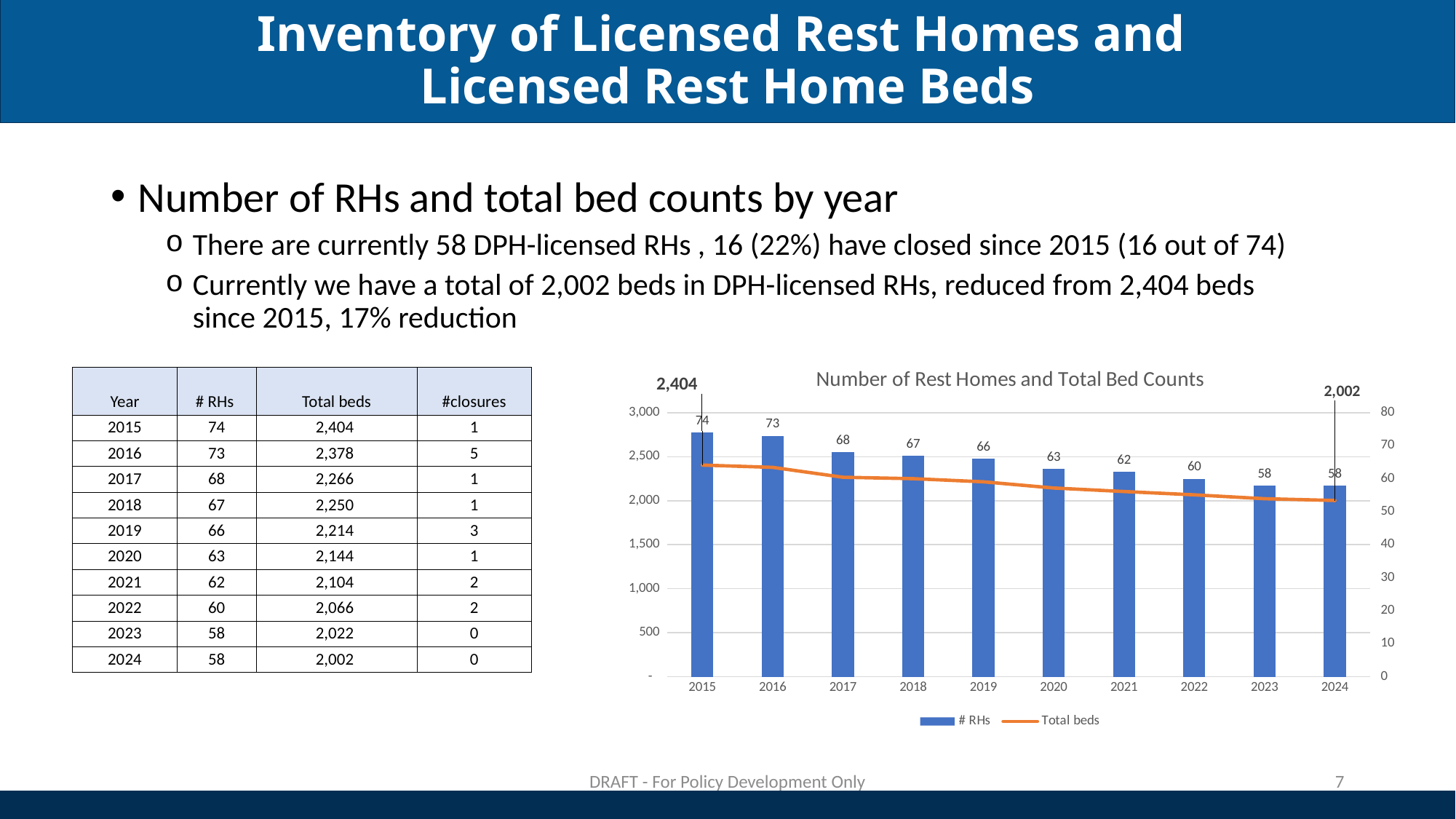
Is the Total beds value for 2019 greater or less than 2,000? greater What is the value of # RHs for 2020 in the chart? 63 How many years are shown on the x axis of the chart? 10 How many series does the chart legend list? 2 What is the difference in Total beds between 2015 and 2024 as labelled in the chart? 402 What is the title of the chart? Number of Rest Homes and Total Bed Counts Which is larger in the chart, # RHs for 2017 or # RHs for 2021? 2017 What is the Total beds value labelled for 2024 in the chart? 2,002 Which year has the highest # RHs in the chart? 2015 What is the difference in # RHs between 2015 and 2024 in the chart? 16 What is the value of # RHs for 2015 in the chart? 74 Do the # RHs values rise or fall from 2015 to 2024 in the chart? fall